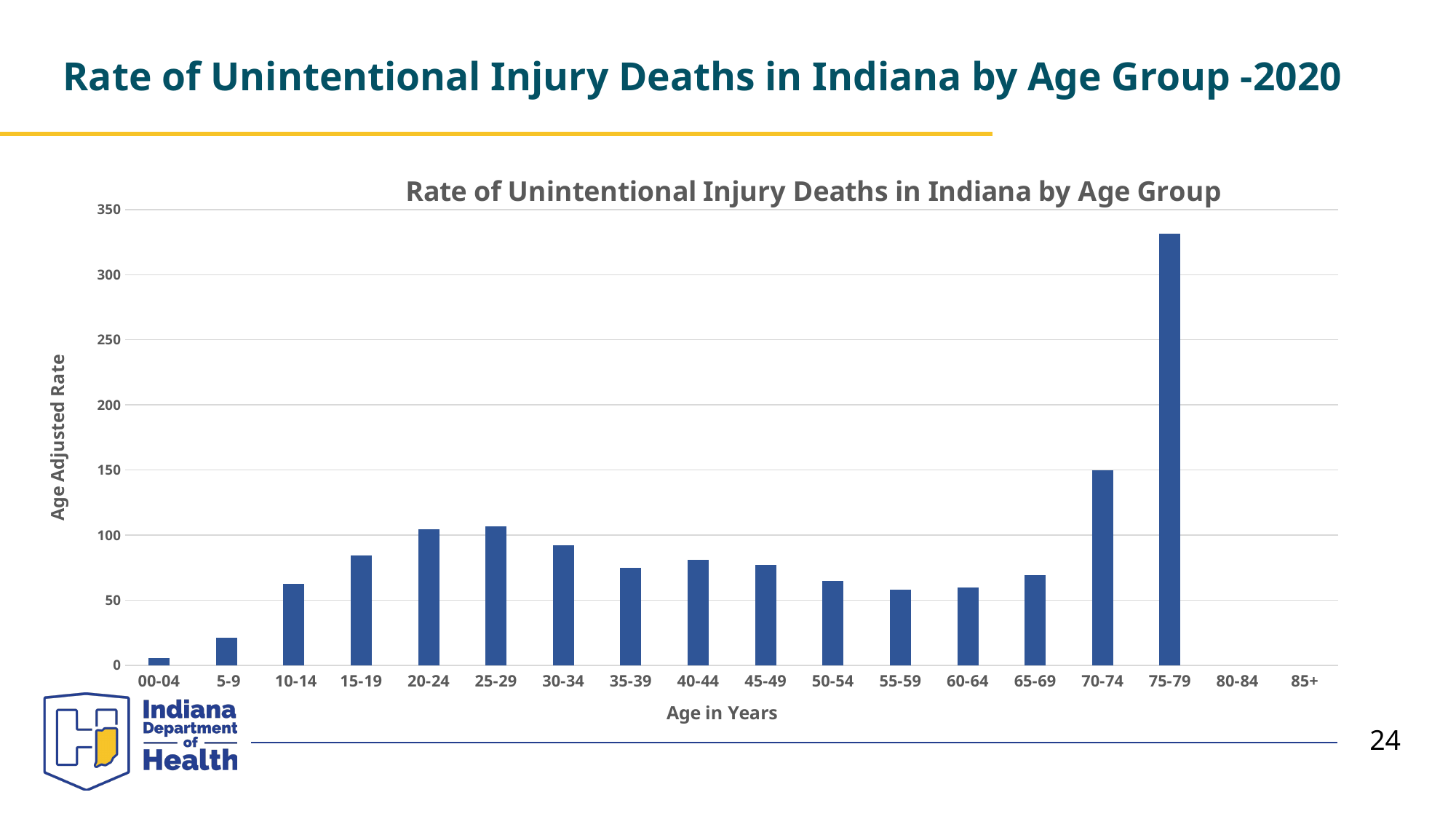
How many age groups are listed along the x axis? 18 Which age group has the larger value, 25-29 or 30-34? 25-29 Is the value for the 00-04 age group greater or less than 50? less Which age group has the larger value, 65-69 or 70-74? 70-74 Is the value for the 70-74 age group greater or less than 100? greater What is the title of the vertical axis? Age Adjusted Rate Is the value for the 75-79 age group greater or less than 300? greater Which age group has the highest age adjusted rate of unintentional injury deaths? 75-79 What kind of chart is shown on the slide? Bar chart Do the values rise or fall from the 00-04 age group to the 25-29 age group? rise